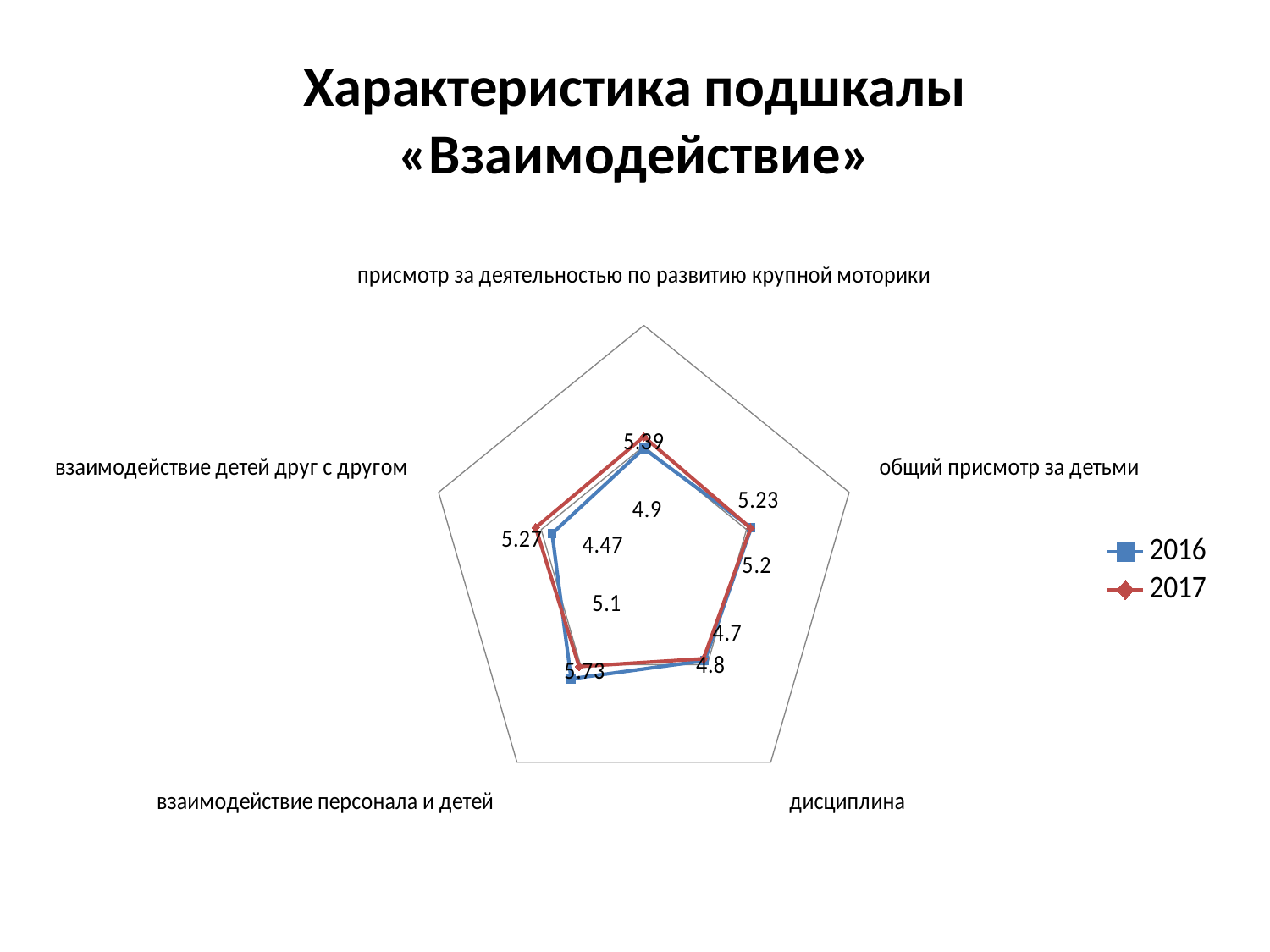
What kind of chart is shown on the slide? radar chart Which series are listed in the legend? 2016 and 2017 Which category label appears on the right side of the radar chart? общий присмотр за детьми Which category label appears at the top of the radar chart? присмотр за деятельностью по развитию крупной моторики Which category label appears at the bottom right of the radar chart? дисциплина What is the title of the slide? Характеристика подшкалы «Взаимодействие» Which category label appears on the left side of the radar chart? взаимодействие детей друг с другом How many series does the legend list? 2 Which category label appears at the bottom left of the radar chart? взаимодействие персонала и детей How many categories (axes) does the radar chart have? 5